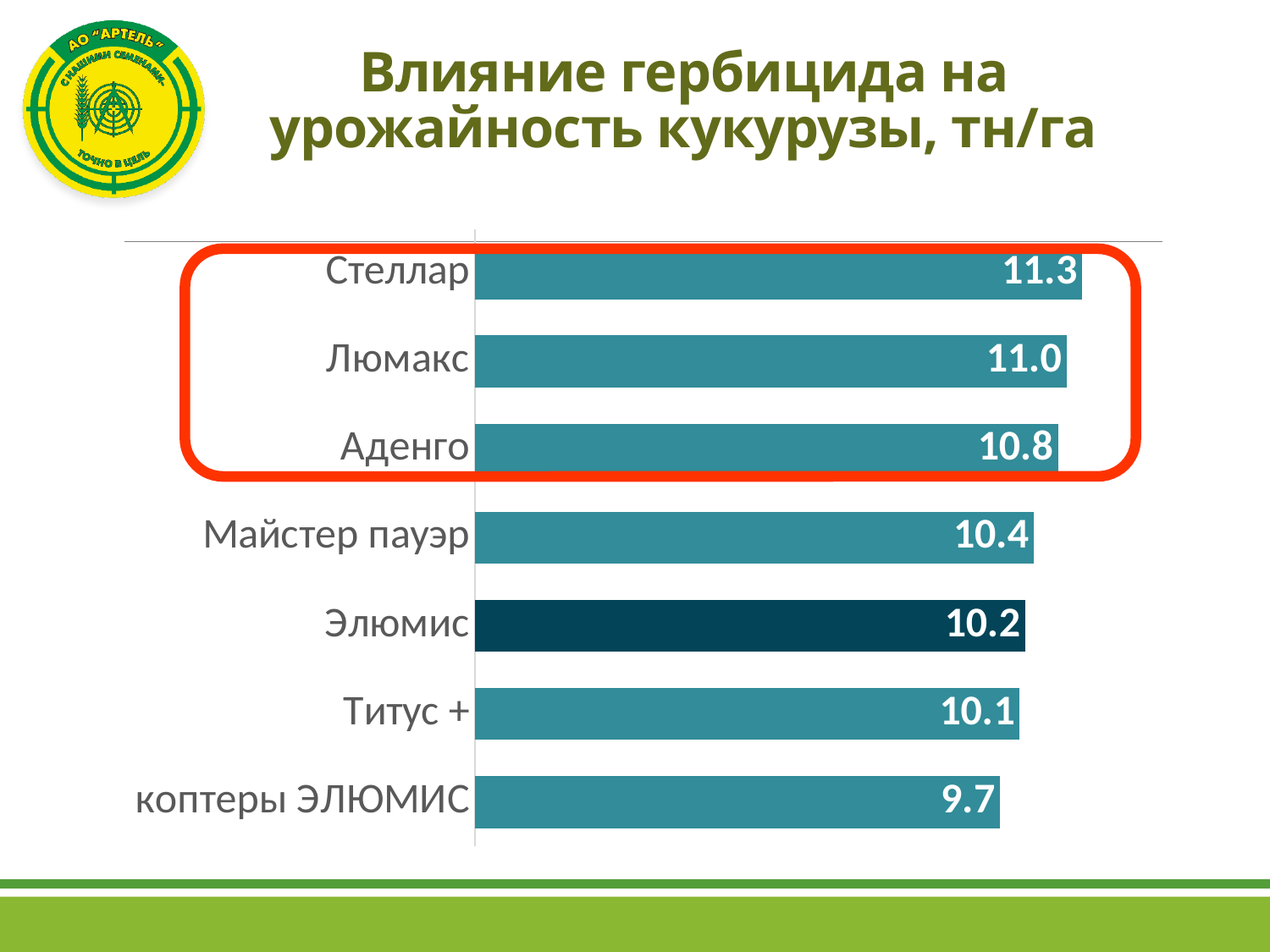
What is the difference between the values for Люмакс and коптеры ЭЛЮМИС? 1.3 What is the yield value for Майстер пауэр? 10.4 Which has a larger value, Титус + or Майстер пауэр? Майстер пауэр How many herbicides are shown in the chart? 7 What is the yield value for коптеры ЭЛЮМИС? 9.7 What is the difference between the values for Стеллар and Аденго? 0.5 Which herbicide has the lowest yield value? коптеры ЭЛЮМИС Which herbicide has the highest yield value? Стеллар What is the yield value for Элюмис? 10.2 What is the yield value for Стеллар? 11.3 What kind of chart is shown on the slide? Bar chart Which bar is drawn in a darker colour than the others? Элюмис